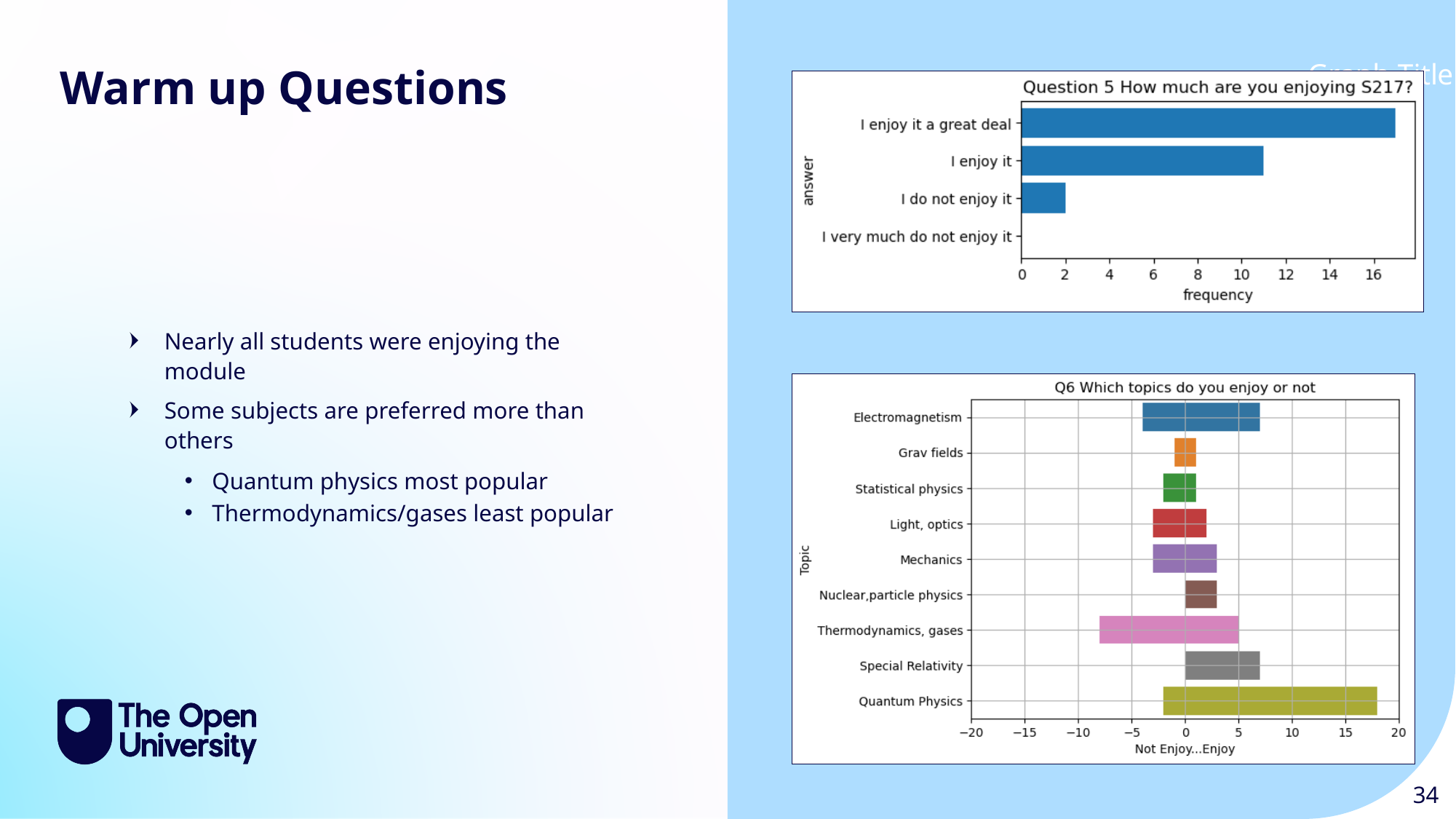
In the bottom chart 'Q6 Which topics do you enjoy or not', how many topics are listed on the y axis? 9 In the top chart 'Question 5 How much are you enjoying S217?', is the frequency for 'I enjoy it a great deal' greater or less than 16? greater In the top chart 'Question 5 How much are you enjoying S217?', which answer has the highest frequency? I enjoy it a great deal In the top chart 'Question 5 How much are you enjoying S217?', how many answer categories are shown on the y axis? 4 In the top chart 'Question 5 How much are you enjoying S217?', is the frequency for 'I do not enjoy it' greater or less than 4? less In the bottom chart 'Q6 Which topics do you enjoy or not', which topic's bar extends furthest to the right (Enjoy side)? Quantum Physics What type of chart is the top chart titled 'Question 5 How much are you enjoying S217?'? bar chart In the top chart 'Question 5 How much are you enjoying S217?', which answer has the lowest frequency? I very much do not enjoy it In the top chart 'Question 5 How much are you enjoying S217?', is the frequency for 'I enjoy it' greater or less than 10? greater In the top chart 'Question 5 How much are you enjoying S217?', which has the higher frequency: 'I enjoy it' or 'I do not enjoy it'? I enjoy it What is the x-axis label of the bottom chart 'Q6 Which topics do you enjoy or not'? Not Enjoy...Enjoy In the bottom chart 'Q6 Which topics do you enjoy or not', which topic's bar extends furthest to the left (Not Enjoy side)? Thermodynamics, gases